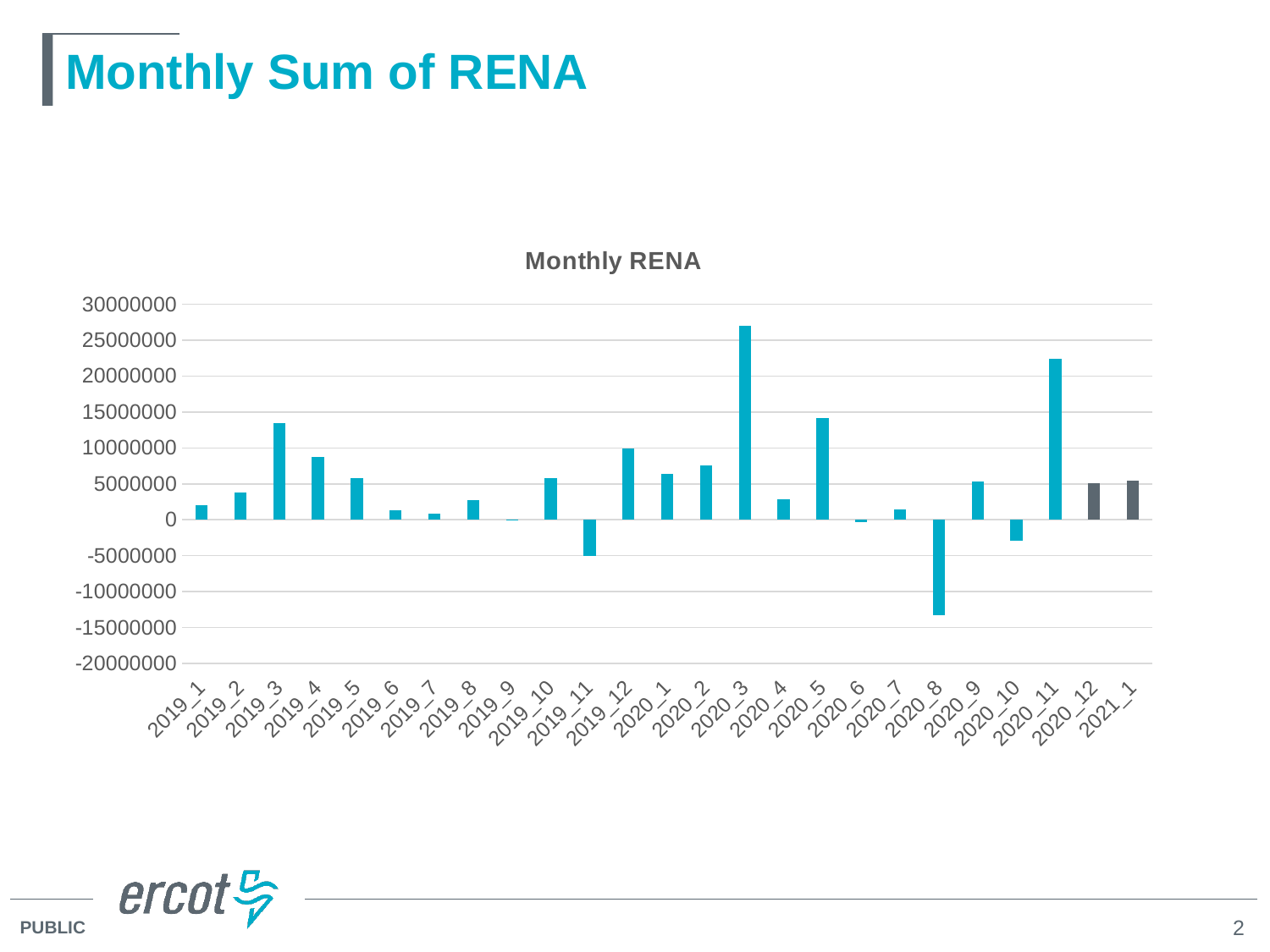
Is the value for 2019_3 greater or less than 10000000? greater Which is larger, the value for 2020_11 or the value for 2020_5? 2020_11 What is the title of the chart? Monthly RENA Is the value for 2020_3 greater or less than 25000000? greater Is the value for 2020_8 greater or less than -10000000? less Which two months are shown with dark grey bars instead of teal bars? 2020_12 and 2021_1 How many months (categories) are plotted on the x axis? 25 What type of chart is shown on the slide? bar chart Which month has the lowest Monthly RENA value? 2020_8 Which month has the highest Monthly RENA value? 2020_3 Which is larger, the value for 2019_3 or the value for 2019_4? 2019_3